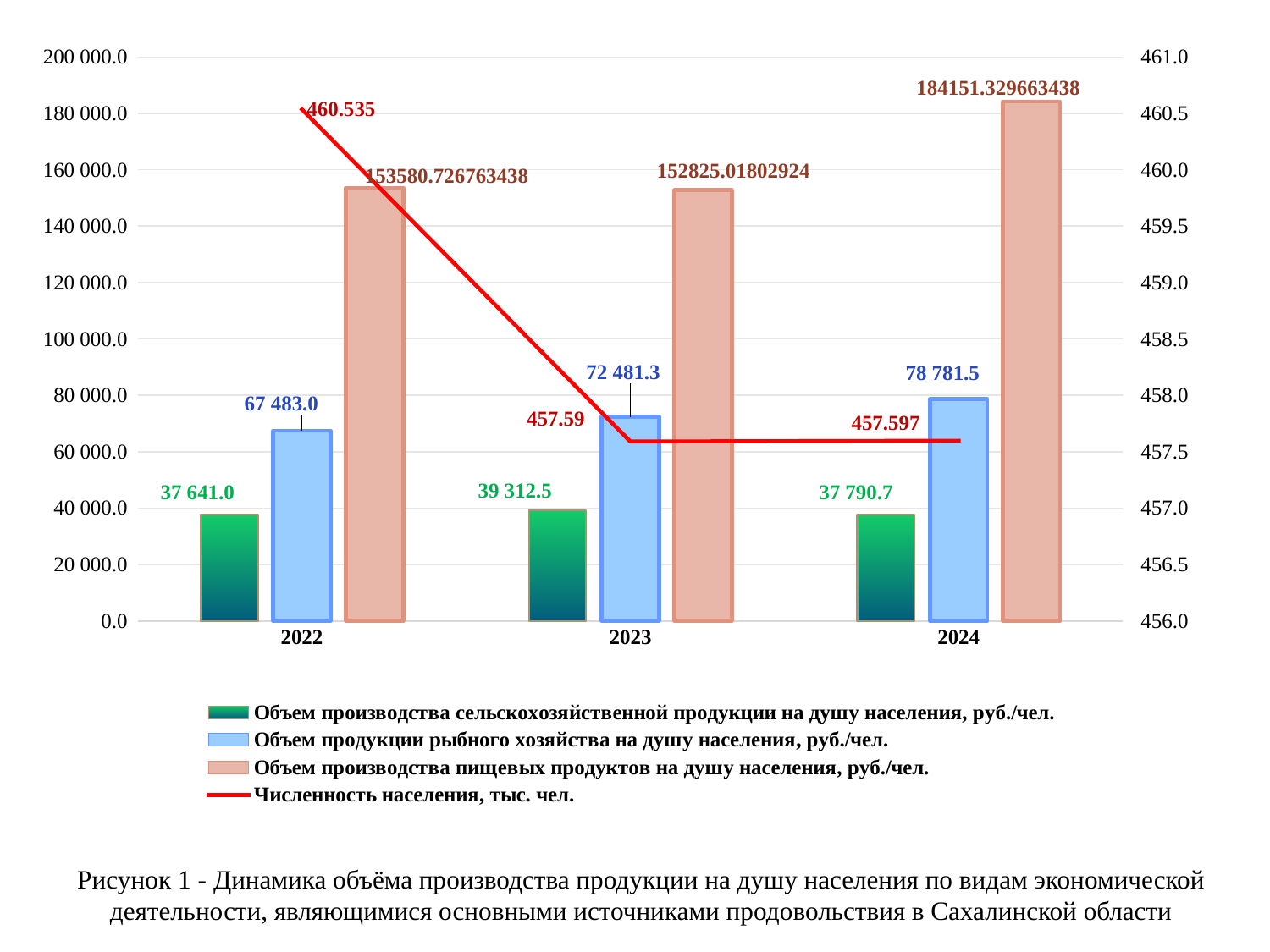
What is the value of 'Численность населения, тыс. чел.' for 2022? 460.535 Does 'Объем продукции рыбного хозяйства на душу населения, руб./чел.' rise or fall from 2022 to 2024? rise How many series does the legend list? 4 In which year is 'Объем продукции рыбного хозяйства на душу населения, руб./чел.' highest? 2024 What is the difference between the 2024 and 2022 values of 'Объем продукции рыбного хозяйства на душу населения, руб./чел.'? 11 298.5 What kind of chart is shown on the slide? Combined bar and line chart In which year is 'Объем производства сельскохозяйственной продукции на душу населения, руб./чел.' lowest? 2022 What is the value of 'Объем производства пищевых продуктов на душу населения, руб./чел.' for 2024? 184151.329663438 Which year has the larger value for 'Объем производства сельскохозяйственной продукции на душу населения, руб./чел.': 2023 or 2024? 2023 What is the value of 'Объем продукции рыбного хозяйства на душу населения, руб./чел.' for 2023? 72 481.3 How many years are shown on the x axis of the chart? 3 Is the value for 'Объем производства пищевых продуктов на душу населения, руб./чел.' in 2024 greater or less than 180 000.0? greater